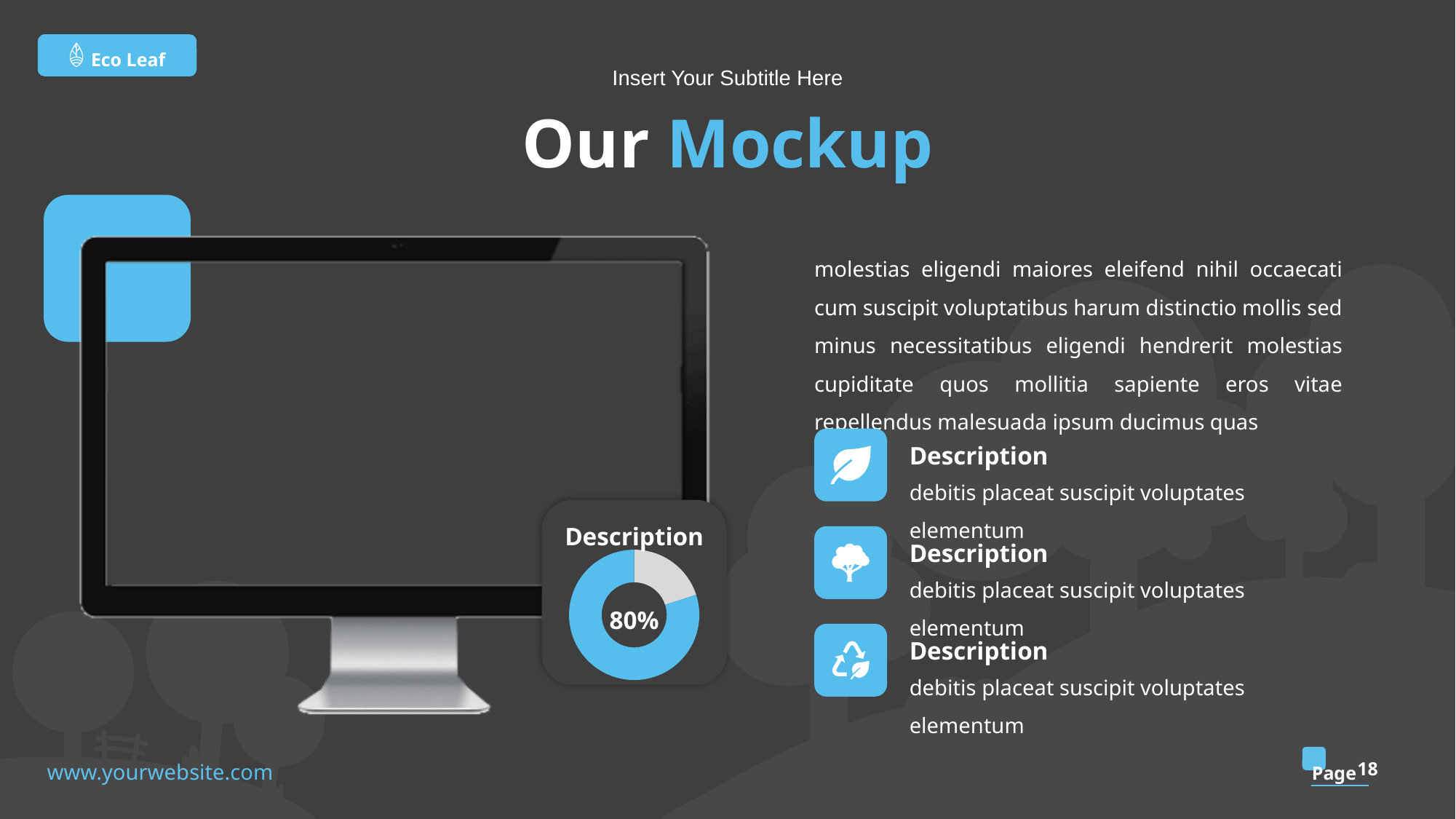
What colour is the largest slice of the donut chart? Blue Which slice of the donut chart is the smallest? The grey slice Is the blue slice of the donut chart greater or less than 50%? greater How many slices does the donut chart have? 2 What is the title shown above the donut chart? Description Which slice of the donut chart is larger, the blue one or the grey one? Blue What percentage is printed in the centre of the donut chart? 80% What share of the donut chart does the blue slice represent? 80% What kind of chart is shown in the box labelled "Description" next to the monitor? Donut chart